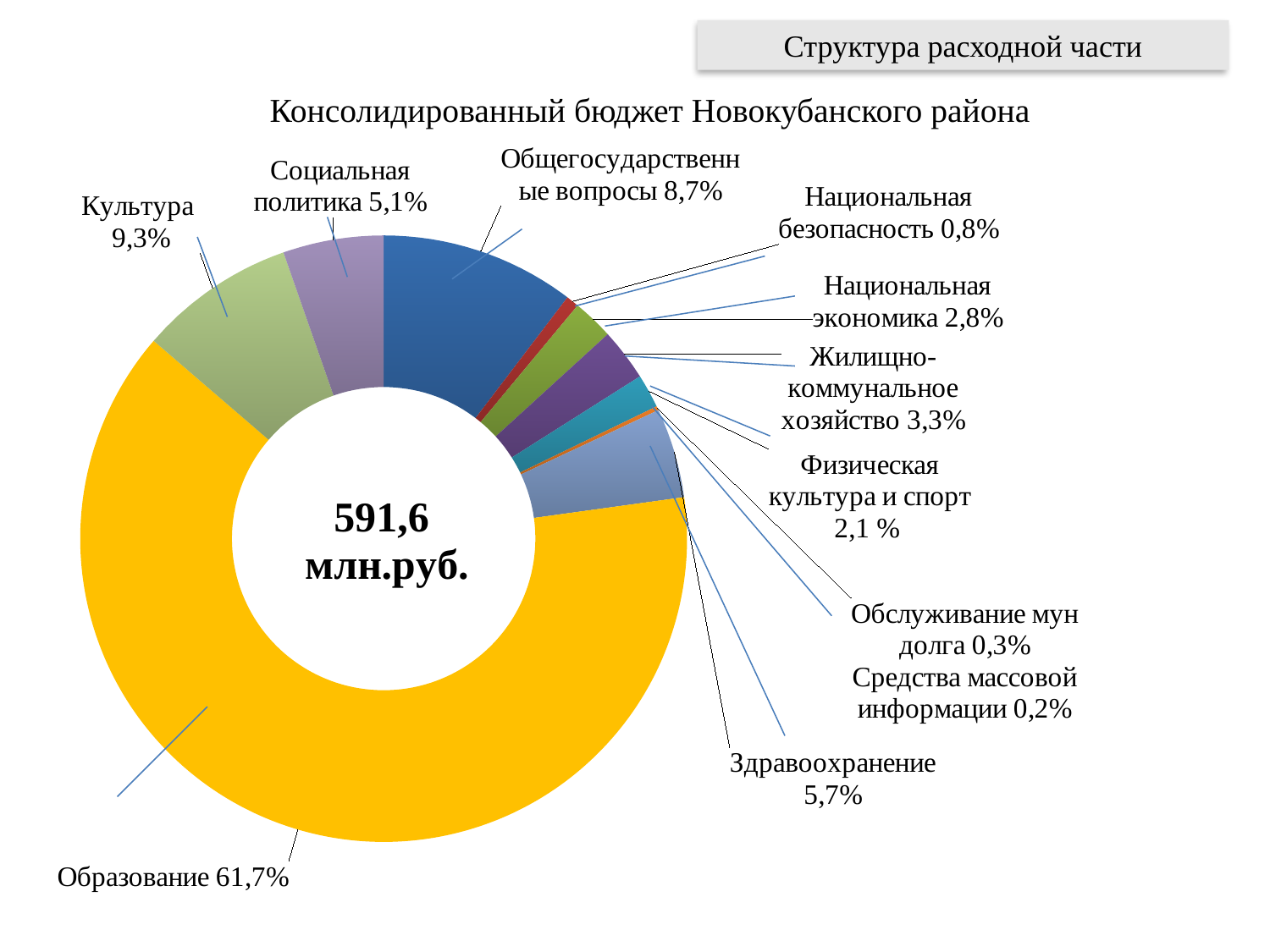
Which category has the largest share of expenditure? Образование What kind of chart is shown on the slide? Doughnut (pie) chart What total amount is shown in the centre of the chart? 591,6 млн.руб. What share of the consolidated budget expenditure goes to Образование? 61,7% Which category has the smallest share of expenditure? Средства массовой информации What share is shown for Здравоохранение? 5,7% What share is shown for Жилищно-коммунальное хозяйство? 3,3% What is the difference in percentage points between Культура (9,3%) and Здравоохранение (5,7%)? 3,6 What is the title of the chart? Консолидированный бюджет Новокубанского района Which has a larger share: Культура or Социальная политика? Культура What share is shown for Общегосударственные вопросы? 8,7% How many expenditure categories are shown in the chart? 11